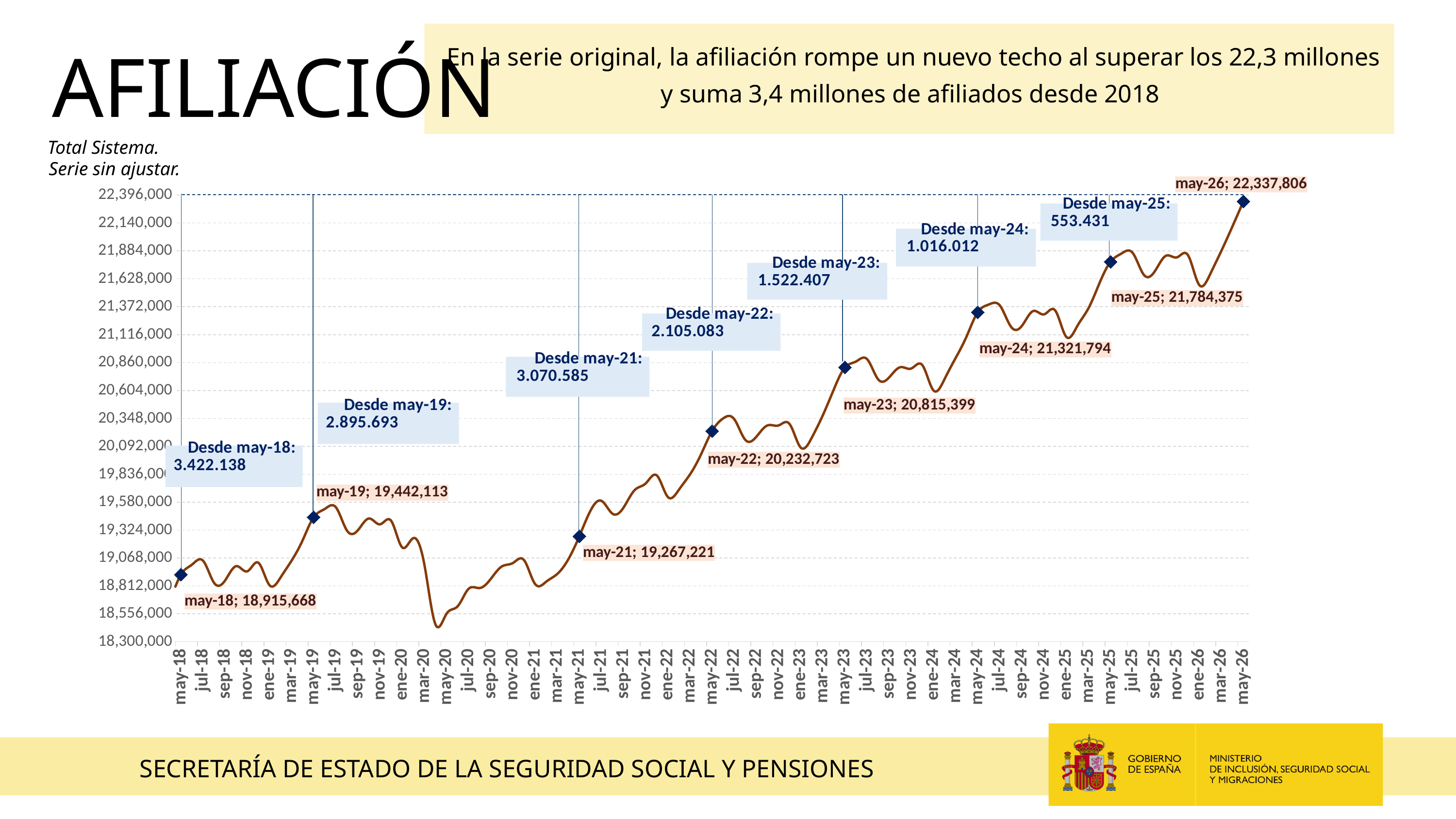
Which labelled point has the lowest value? may-18 What is the value labelled for may-23? 20,815,399 Which is larger, the value for may-22 or the value for may-19? may-22 What kind of chart is shown on the slide? line chart What is the difference between the may-26 value and the may-18 value? 3,422,138 Which labelled point has the highest value? may-26 Is the value for may-20 greater or less than 18,812,000? less What is the value labelled for may-18? 18,915,668 Overall, does the line rise or fall from may-18 to may-26? rise What is the difference between the may-26 value and the may-25 value? 553,431 What is the value labelled for may-26? 22,337,806 What is the value labelled for may-21? 19,267,221